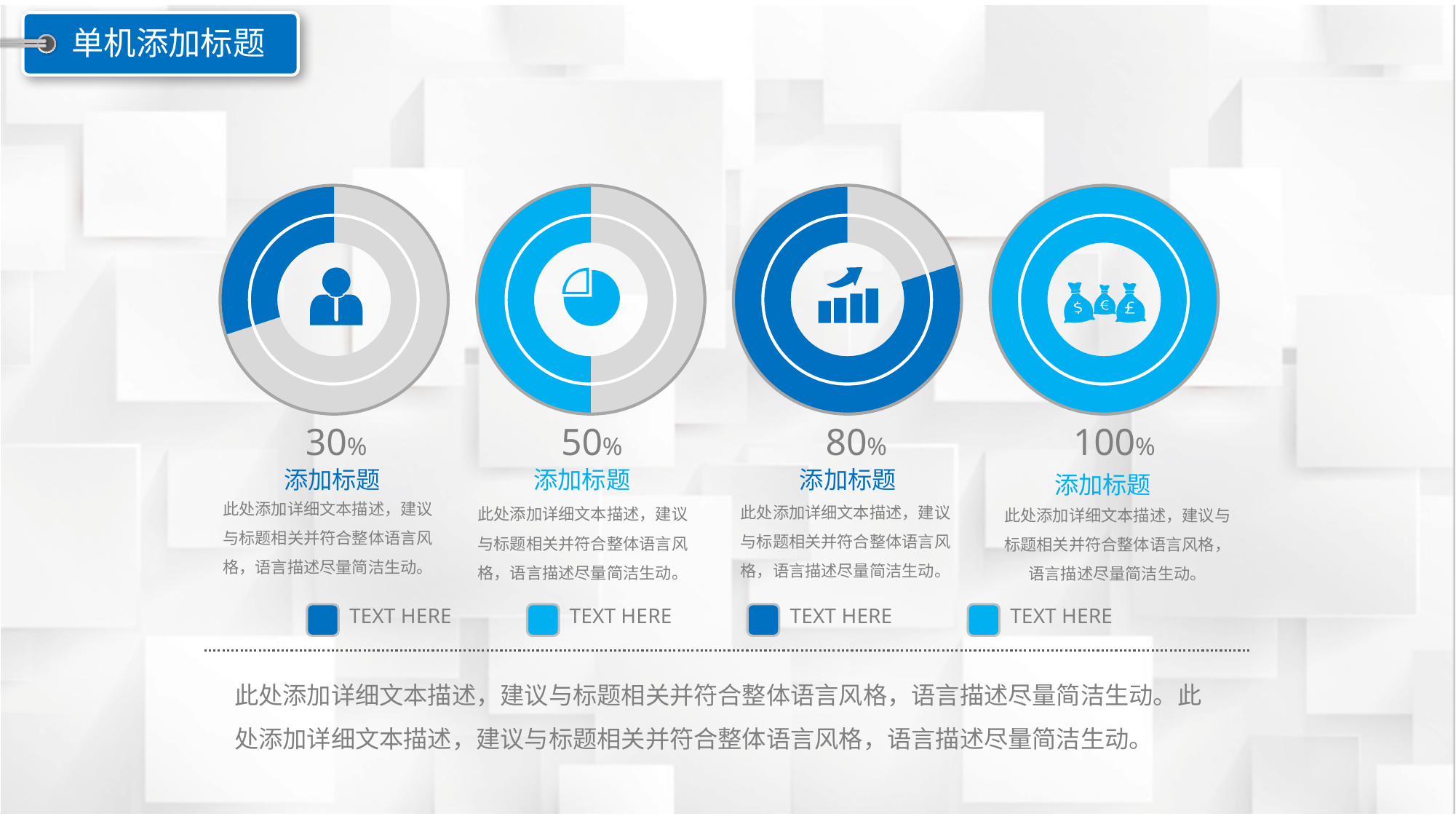
What kind of chart is used to display each percentage on the slide? Ring (donut) chart What is the difference between the percentage of the rightmost ring chart and the leftmost ring chart? 70% What percentage is shown below the leftmost ring chart (with the person icon)? 30% Which ring chart shows the lowest percentage? The leftmost one (30%) Which ring chart shows the highest percentage? The rightmost one (100%) Do the percentages increase or decrease from left to right across the four ring charts? Increase What is the difference between the percentages of the third and second ring charts from the left? 30% What percentage is shown below the rightmost ring chart (with the money-bag icons)? 100% What percentage is shown below the third ring chart from the left (with the bar-chart icon)? 80% What percentage is shown below the second ring chart from the left (with the pie icon)? 50% Which is larger, the percentage of the second ring chart from the left or the third ring chart from the left? The third (80%) How many ring charts are shown on the slide? 4